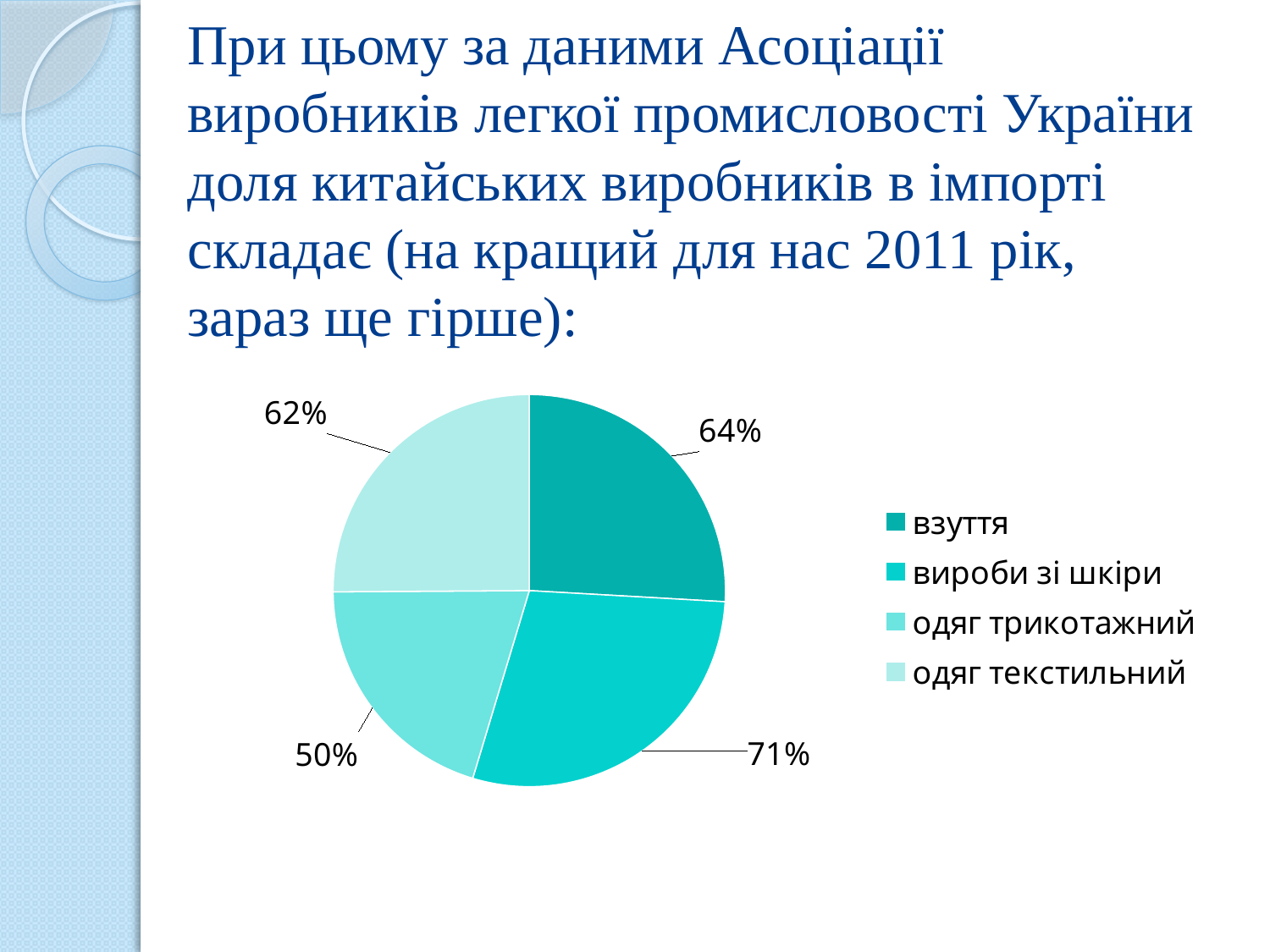
What is the value shown for взуття? 64% Which category has the highest value in the pie chart? вироби зі шкіри What kind of chart is shown on the slide? pie chart What is the value shown for вироби зі шкіри? 71% Which has the larger value, взуття or одяг текстильний? взуття What is the difference between the values for вироби зі шкіри and одяг трикотажний? 21 percentage points Which category has the lowest value in the pie chart? одяг трикотажний What is the value shown for одяг текстильний? 62% What is the value shown for одяг трикотажний? 50% How many entries does the legend list? 4 Which legend entry is shown in the lightest colour? одяг текстильний How many slices does the pie chart have? 4